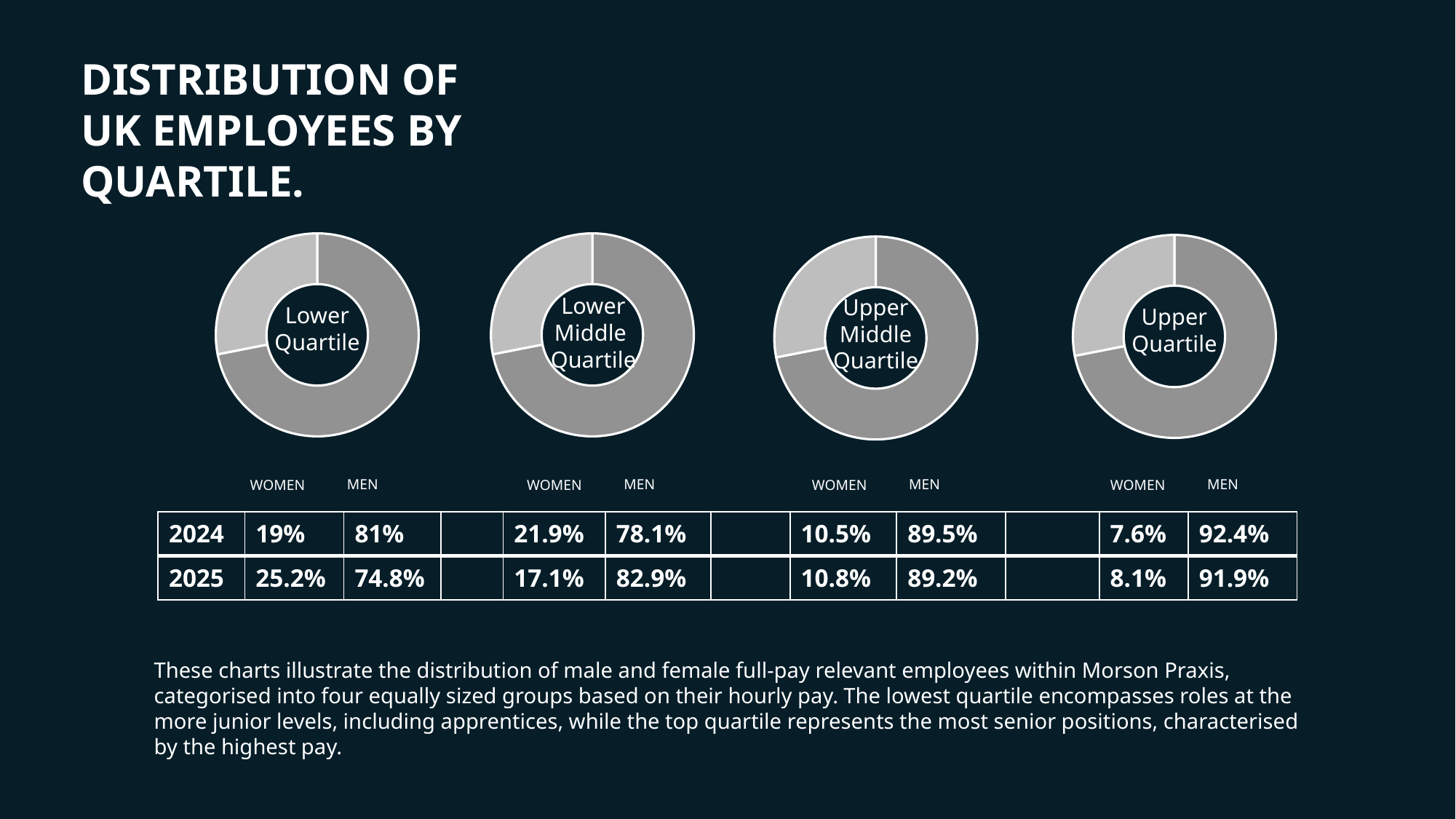
In the Lower Quartile chart, which group has the larger share, women or men? Men According to the table, what was the share of men in the Upper Middle Quartile in 2024? 89.5% In 2024, which quartile had the lowest share of women according to the table? Upper Quartile In 2025, which quartile had the highest share of women according to the table? Lower Quartile How many doughnut charts are on the slide? 4 What kind of charts are shown on the slide? Doughnut (pie) charts According to the table, what was the share of women in the Lower Quartile in 2024? 19% By how many percentage points did the share of women in the Lower Quartile change from 2024 to 2025 according to the table? 6.2 percentage points According to the table, what was the share of women in the Lower Middle Quartile in 2025? 17.1% In the Upper Quartile chart, which group has the smaller share, women or men? Women What is the title of the slide? Distribution of UK employees by quartile. According to the table, what was the share of men in the Upper Quartile in 2025? 91.9%